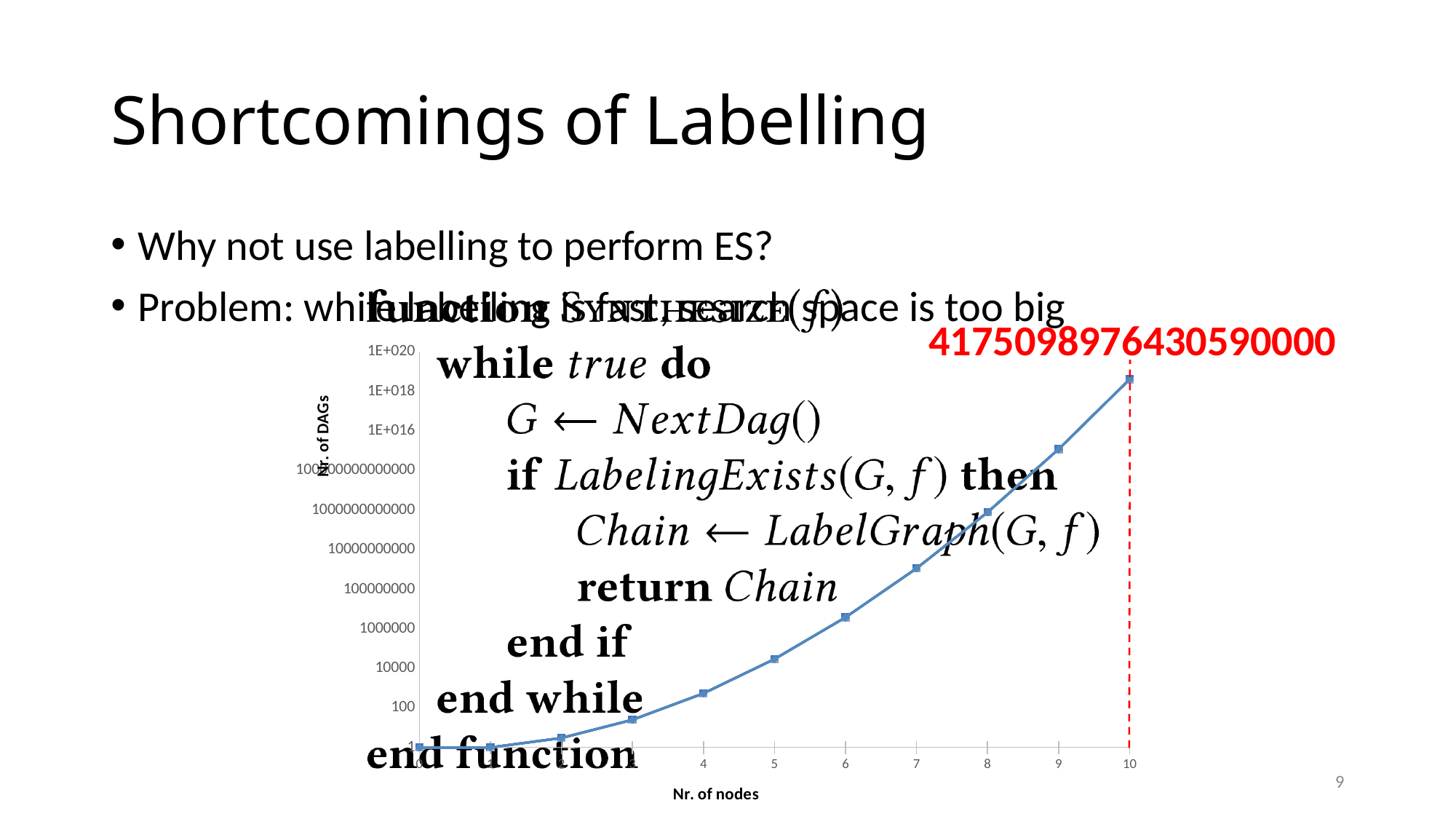
At which number of nodes is the number of DAGs highest? 10 Is the number of DAGs for 6 nodes greater or less than 100000000? less Is the number of DAGs for 7 nodes greater or less than 100000000? greater What is the title of the x axis of the chart? Nr. of nodes What kind of chart is shown on the slide? line chart What value is printed in red for the number of DAGs at 10 nodes? 4175098976430590000 How many data points are plotted on the line? 11 Do the values rise or fall as the number of nodes increases? rise What is the title of the y axis of the chart? Nr. of DAGs Which has more DAGs, 5 nodes or 9 nodes? 9 nodes Is the number of DAGs for 10 nodes greater or less than 1E+018? greater